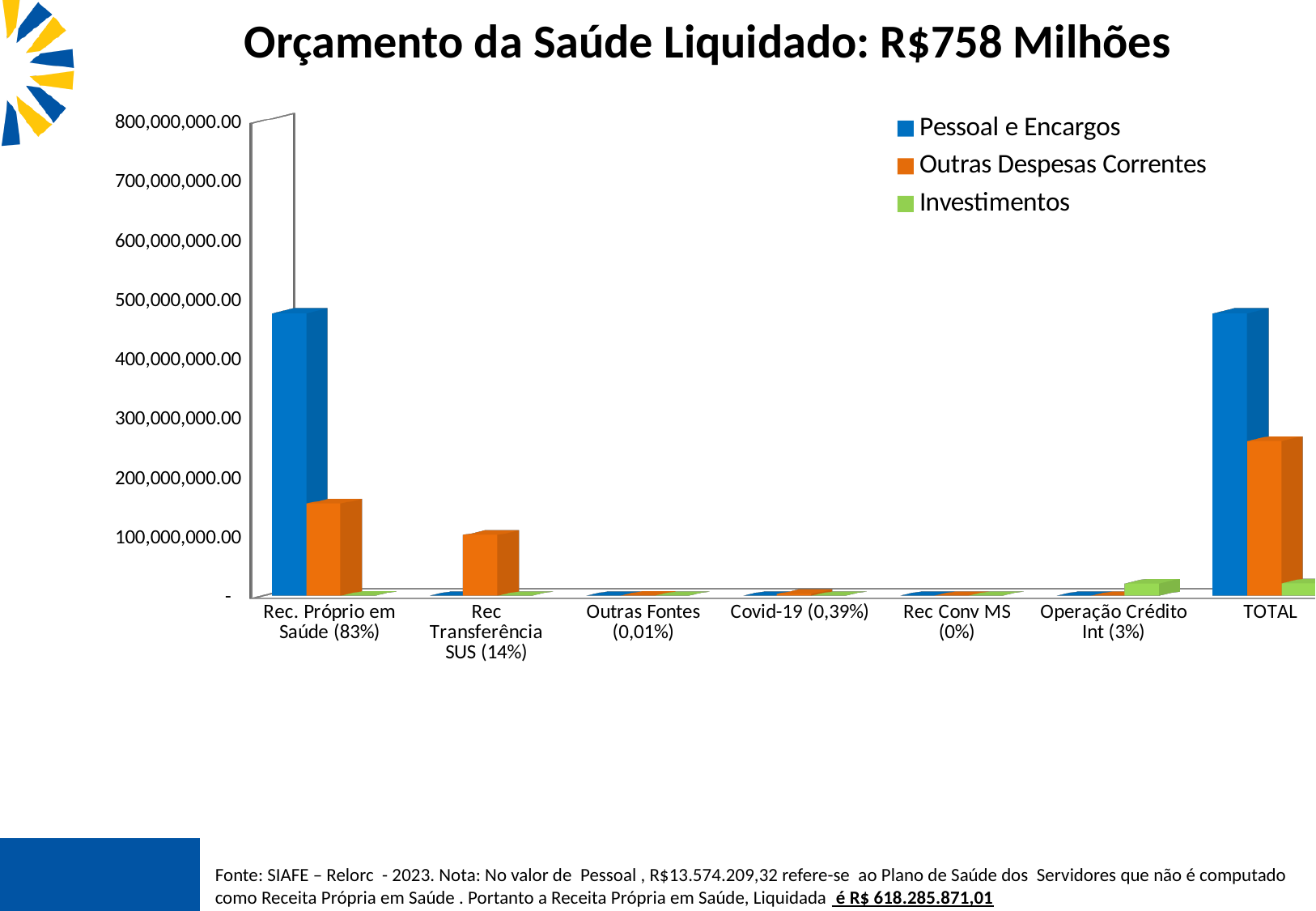
Is the value of Outras Despesas Correntes for Rec. Próprio em Saúde (83%) greater or less than 100,000,000.00? greater For the TOTAL category, which series has the highest value? Pessoal e Encargos How many series does the legend list? 3 Is the value of Investimentos for Operação Crédito Int (3%) greater or less than 100,000,000.00? less Is the value of Outras Despesas Correntes for Rec Transferência SUS (14%) greater or less than 200,000,000.00? less What is the title of the chart? Orçamento da Saúde Liquidado: R$758 Milhões How many categories are shown on the x axis? 7 For Outras Despesas Correntes, which is larger: Rec. Próprio em Saúde (83%) or Rec Transferência SUS (14%)? Rec. Próprio em Saúde (83%) Which series is shown in orange in the legend? Outras Despesas Correntes What kind of chart is shown on the slide? bar chart